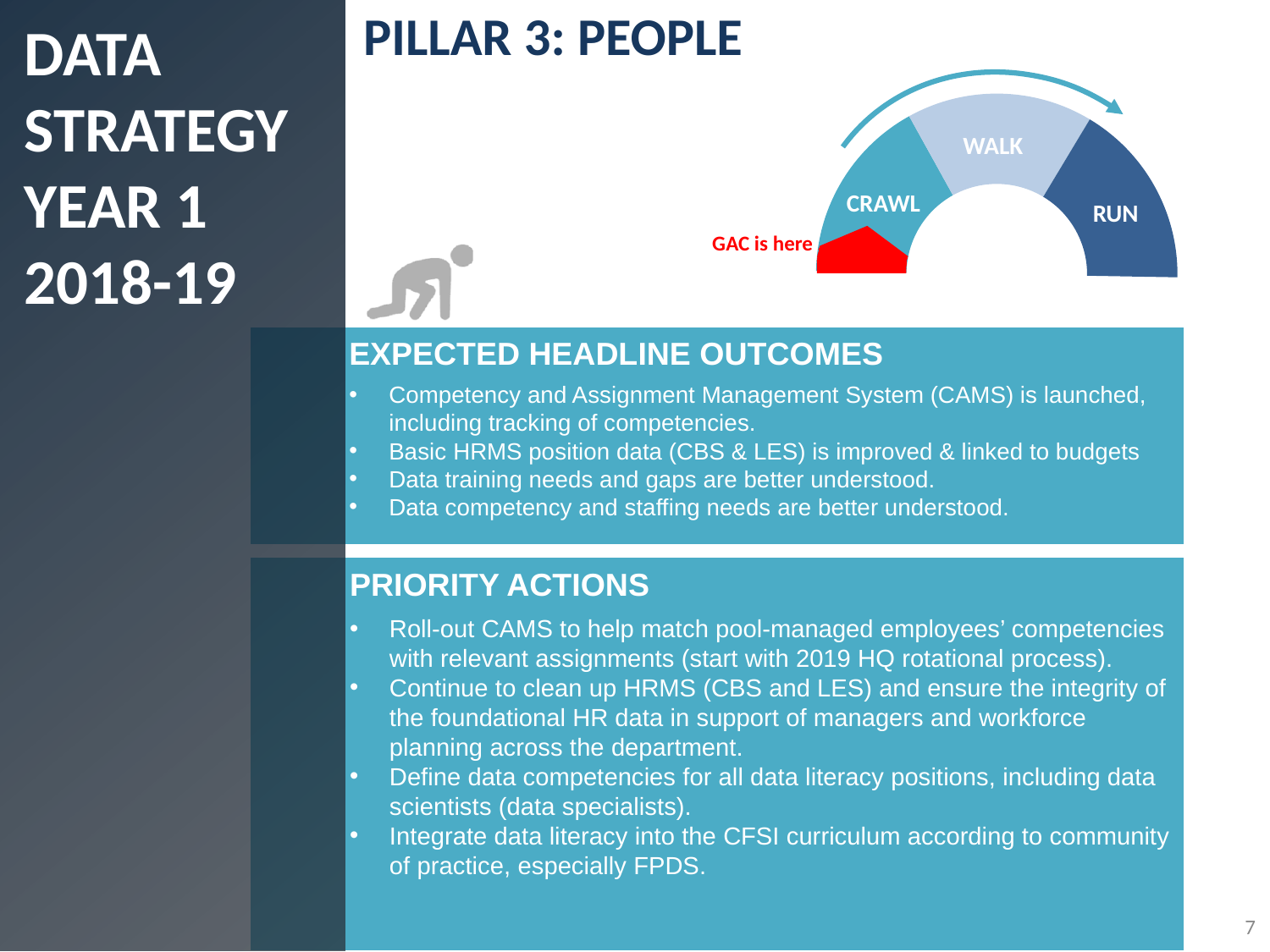
What are the three stages labelled on the gauge chart, in order from left to right? CRAWL, WALK, RUN What colour is the marker showing where GAC is on the gauge chart? Red How many stages are shown on the maturity gauge chart? 3 What kind of chart is used to show the CRAWL, WALK, RUN stages? Gauge chart Which stage of the gauge chart is GAC currently in? CRAWL